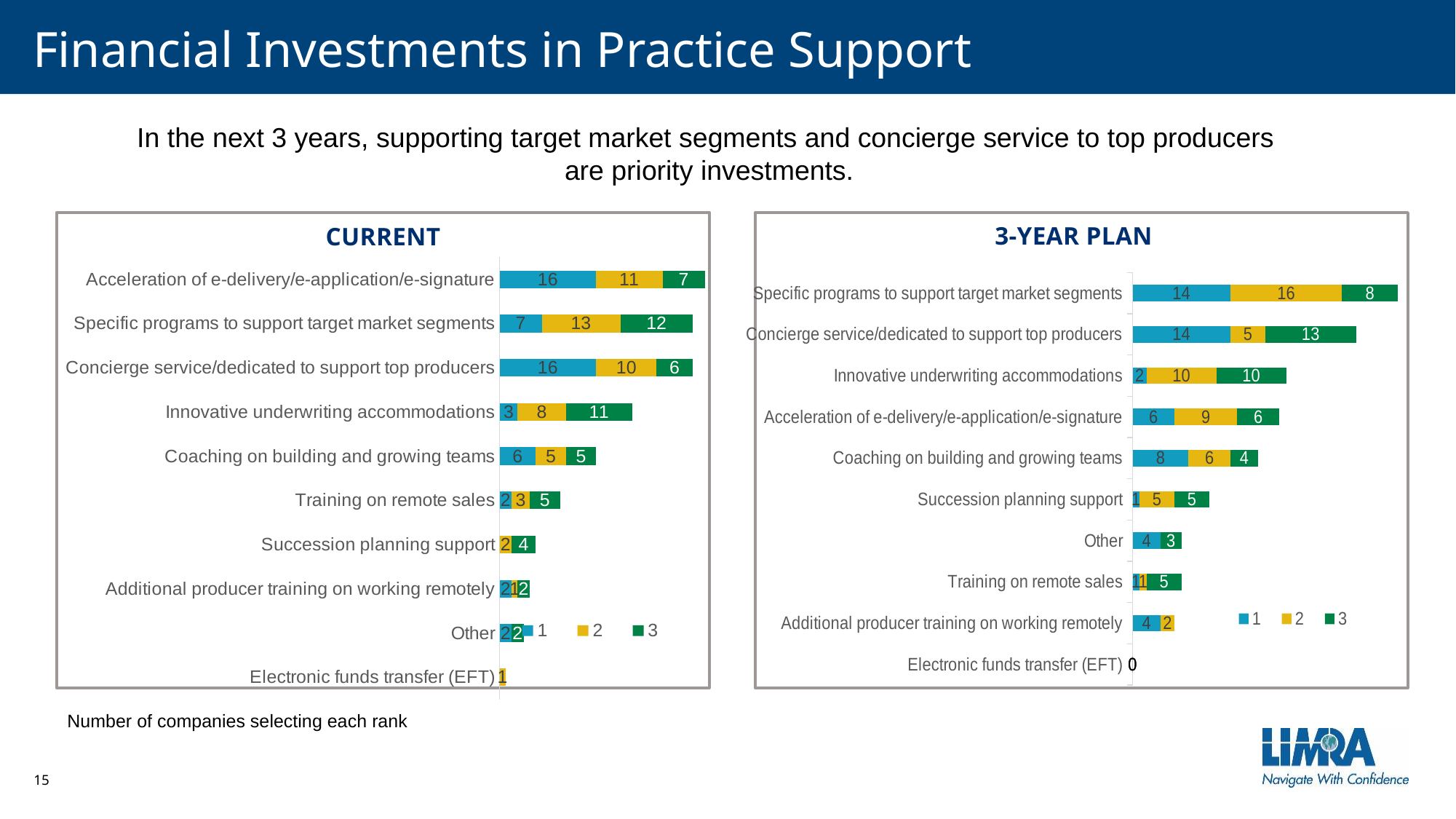
In the 3-YEAR PLAN chart, what is the value for rank 3 for 'Concierge service/dedicated to support top producers'? 13 How many categories are shown in the CURRENT chart? 10 In the 3-YEAR PLAN chart, what is the total of the stacked bar for 'Specific programs to support target market segments'? 38 In the 3-YEAR PLAN chart, what is the value for rank 2 for 'Specific programs to support target market segments'? 16 In the CURRENT chart, what is the difference between the rank 1 and rank 3 values for 'Innovative underwriting accommodations'? 8 In the CURRENT chart, how many companies ranked 'Acceleration of e-delivery/e-application/e-signature' as 1? 16 In the 3-YEAR PLAN chart, is the rank 1 value for 'Coaching on building and growing teams' larger or smaller than its rank 3 value? larger In the CURRENT chart, which category has the longest total bar? Acceleration of e-delivery/e-application/e-signature In the 3-YEAR PLAN chart, which category has a value of 0? Electronic funds transfer (EFT) In the CURRENT chart, what is the total of the stacked bar for 'Specific programs to support target market segments'? 32 How many series does the legend of the 3-YEAR PLAN chart list? 3 What type of chart is the CURRENT chart? Stacked bar chart